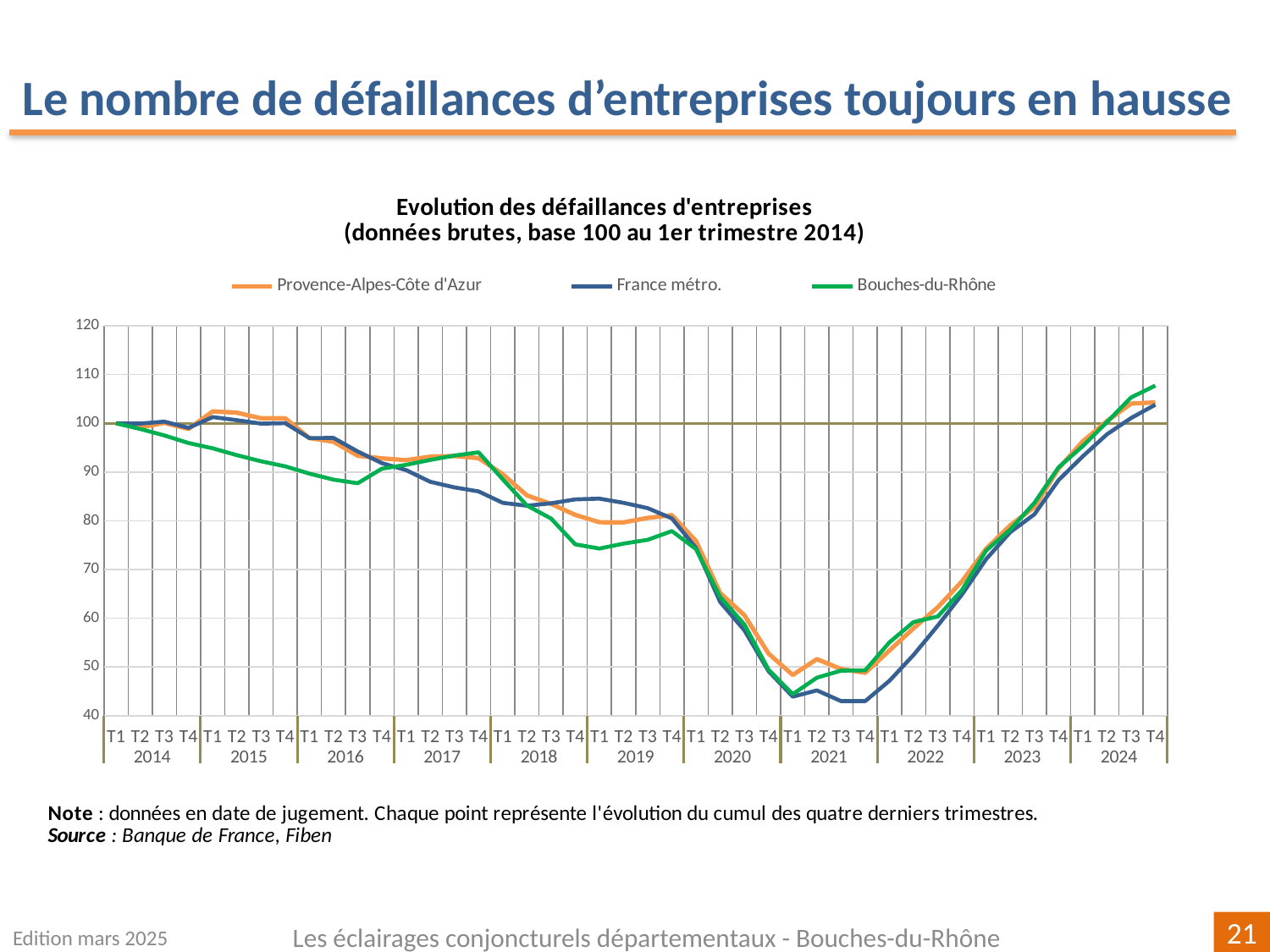
Which series has the highest value at T4 2024? Bouches-du-Rhône Which series are listed in the legend? Provence-Alpes-Côte d'Azur, France métro., Bouches-du-Rhône Do the values of the Provence-Alpes-Côte d'Azur series rise or fall from T1 2021 to T4 2024? rise Is the value for France métro. at T3 2021 greater or less than 50? less How many years are shown along the x axis? 11 Is the value for France métro. at T4 2018 greater or less than 80? greater What kind of chart is shown on the slide? line chart How many series does the legend list? 3 Is the value for Bouches-du-Rhône at T4 2024 greater or less than 100? greater Which series has the lowest value at T3 2021? France métro. What is the value of the Bouches-du-Rhône series at T1 2014? 100